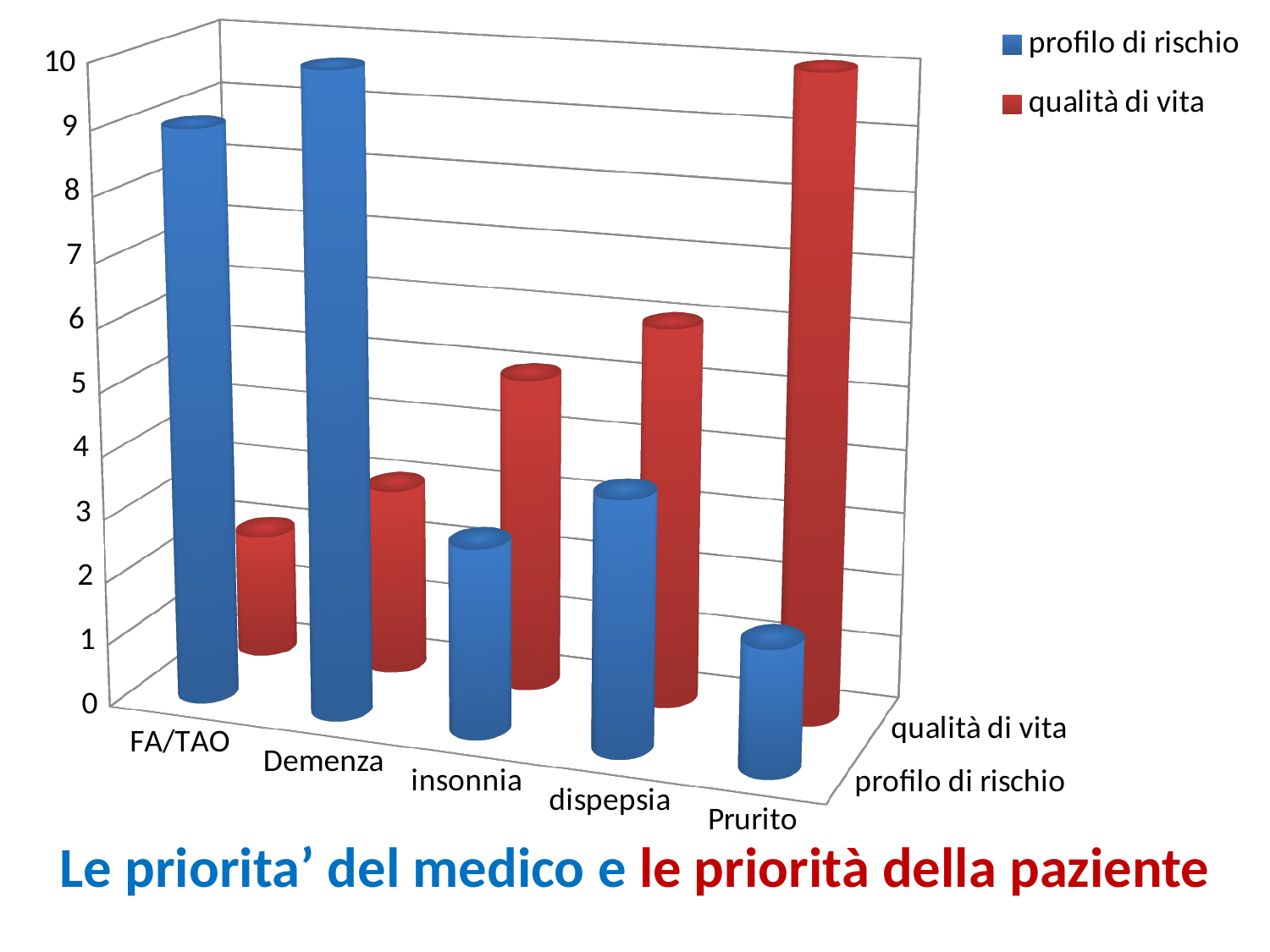
What kind of chart is shown on the slide? bar chart Is the value for FA/TAO in the profilo di rischio series greater or less than 5? greater Do the qualità di vita values generally rise or fall from FA/TAO to Prurito? rise Which category has the highest value for qualità di vita? Prurito How many categories are shown along the x axis? 5 For Prurito, which series has the larger value: profilo di rischio or qualità di vita? qualità di vita How many series does the legend list? 2 Is the value for FA/TAO in the qualità di vita series greater or less than 5? less Which category has the lowest value for profilo di rischio? Prurito Is the value for Prurito in the profilo di rischio series greater or less than 5? less Which colour represents the qualità di vita series? red Which category has the highest value for profilo di rischio? Demenza